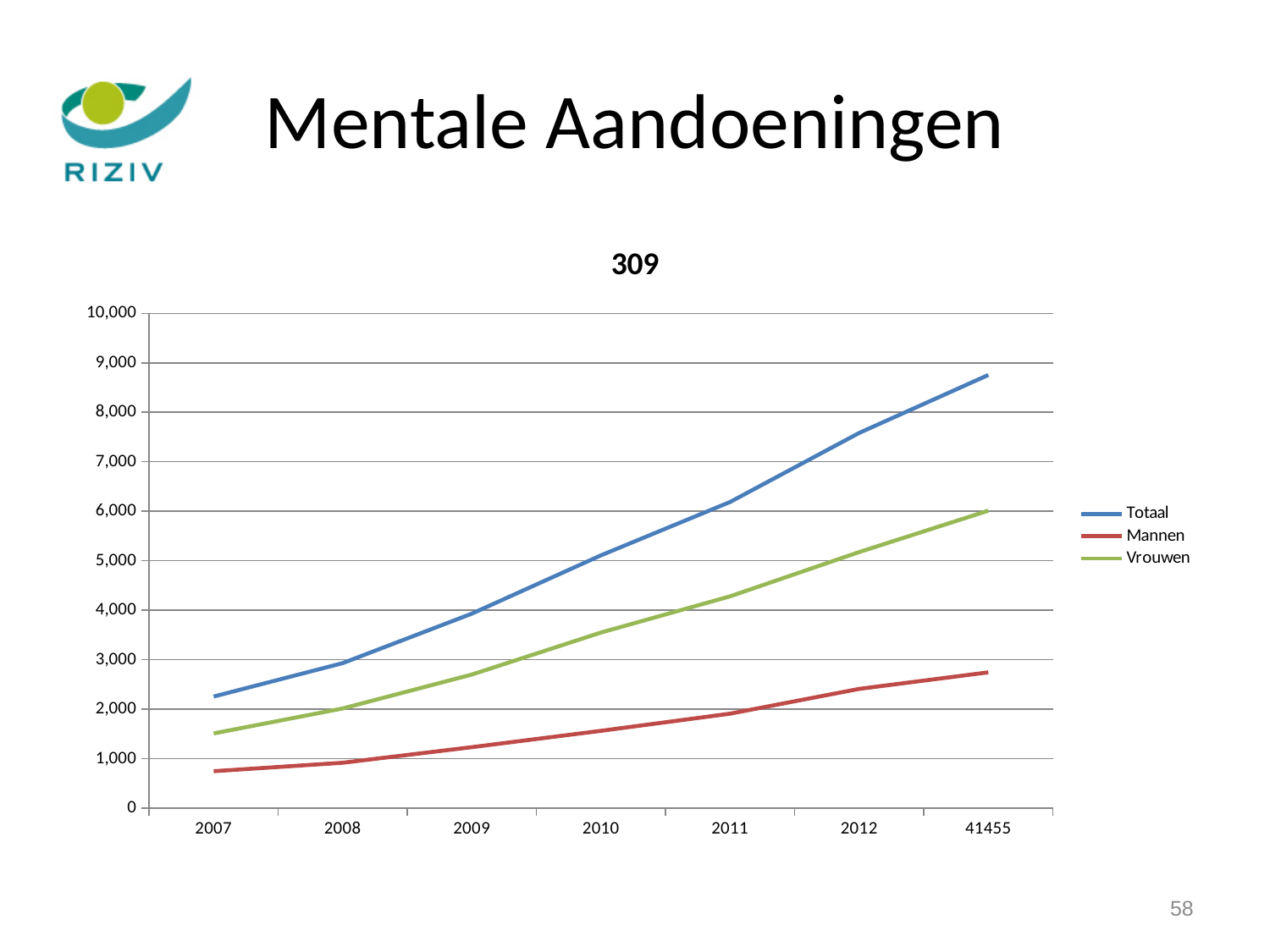
Is the value for Totaal in 2007 greater or less than 2,000? greater Is the value for Totaal at the last x-axis point (41455) greater or less than 8,000? greater Which series has the lowest values across the chart? Mannen What kind of chart is shown on the slide? line chart Which series has the highest values across the chart? Totaal How many series does the legend list? 3 Is the value for Mannen at the last x-axis point (41455) greater or less than 3,000? less How many points are plotted along the x axis for each series? 7 In 2010, which is larger: the value for Vrouwen or the value for Mannen? Vrouwen Does the Totaal line rise or fall from 2007 to the last point on the x axis? rise What is the title of the chart? 309